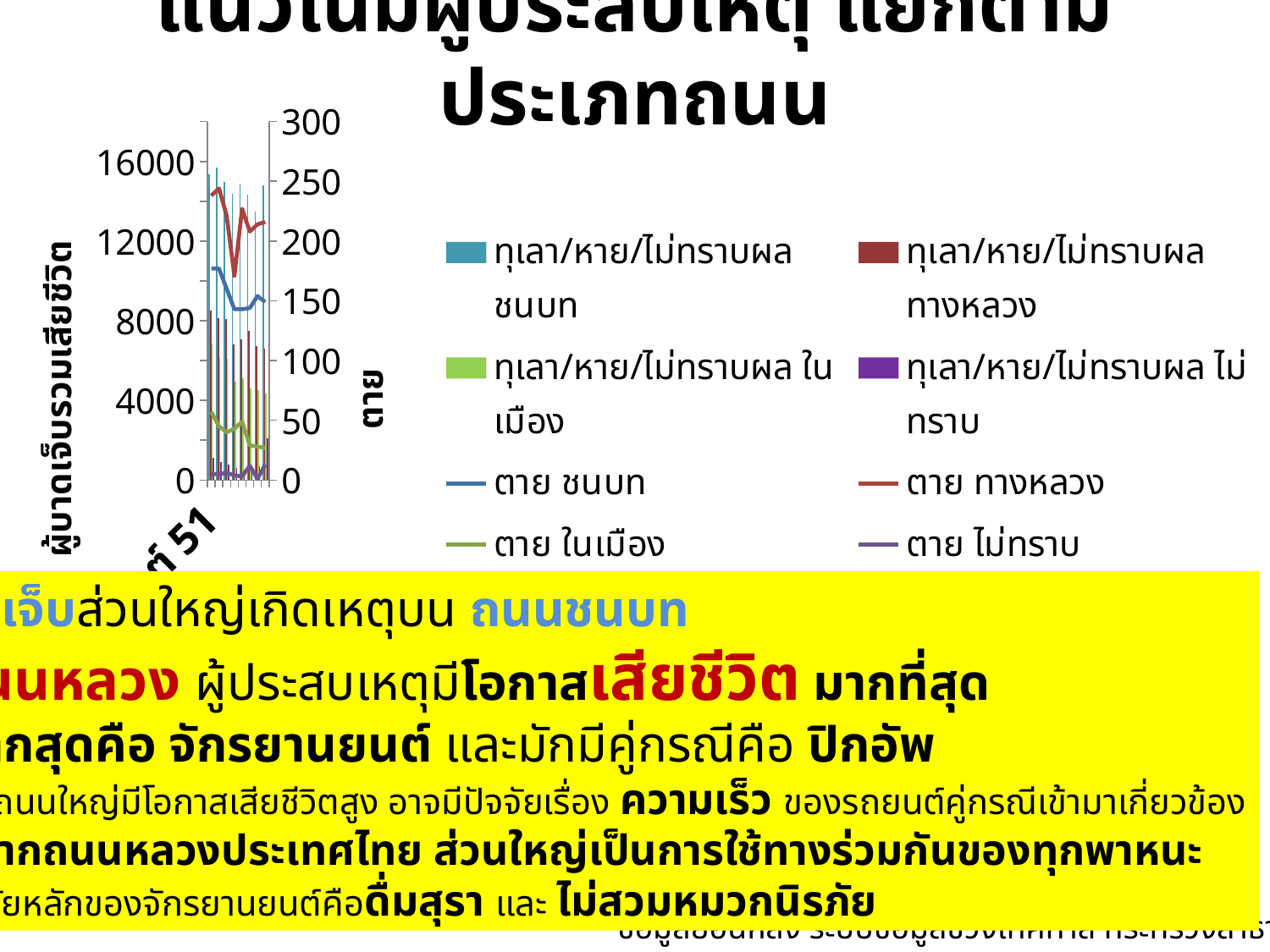
Which bar series is the shortest on the chart? ทุเลา/หาย/ไม่ทราบผล ไม่ทราบ Which bar series is the tallest on the chart? ทุเลา/หาย/ไม่ทราบผล ชนบท Which of the 'ตาย' line series runs lowest on the chart? ตาย ไม่ทราบ Are the values of the ตาย ในเมือง line greater or less than 100 on the right axis? less What is the title of the right vertical axis? ตาย What kind of chart is shown on the slide? Combined bar and line chart Are the values of the ตาย ทางหลวง line greater or less than 150 on the right axis? greater Which line is higher on the chart, ตาย ทางหลวง or ตาย ในเมือง? ตาย ทางหลวง What is the title of the left vertical axis? ผู้บาดเจ็บรวมเสียชีวิต How many series does the chart legend list? 8 Are the values of the ตาย ไม่ทราบ line greater or less than 50 on the right axis? less Which of the 'ตาย' line series runs highest on the chart? ตาย ทางหลวง